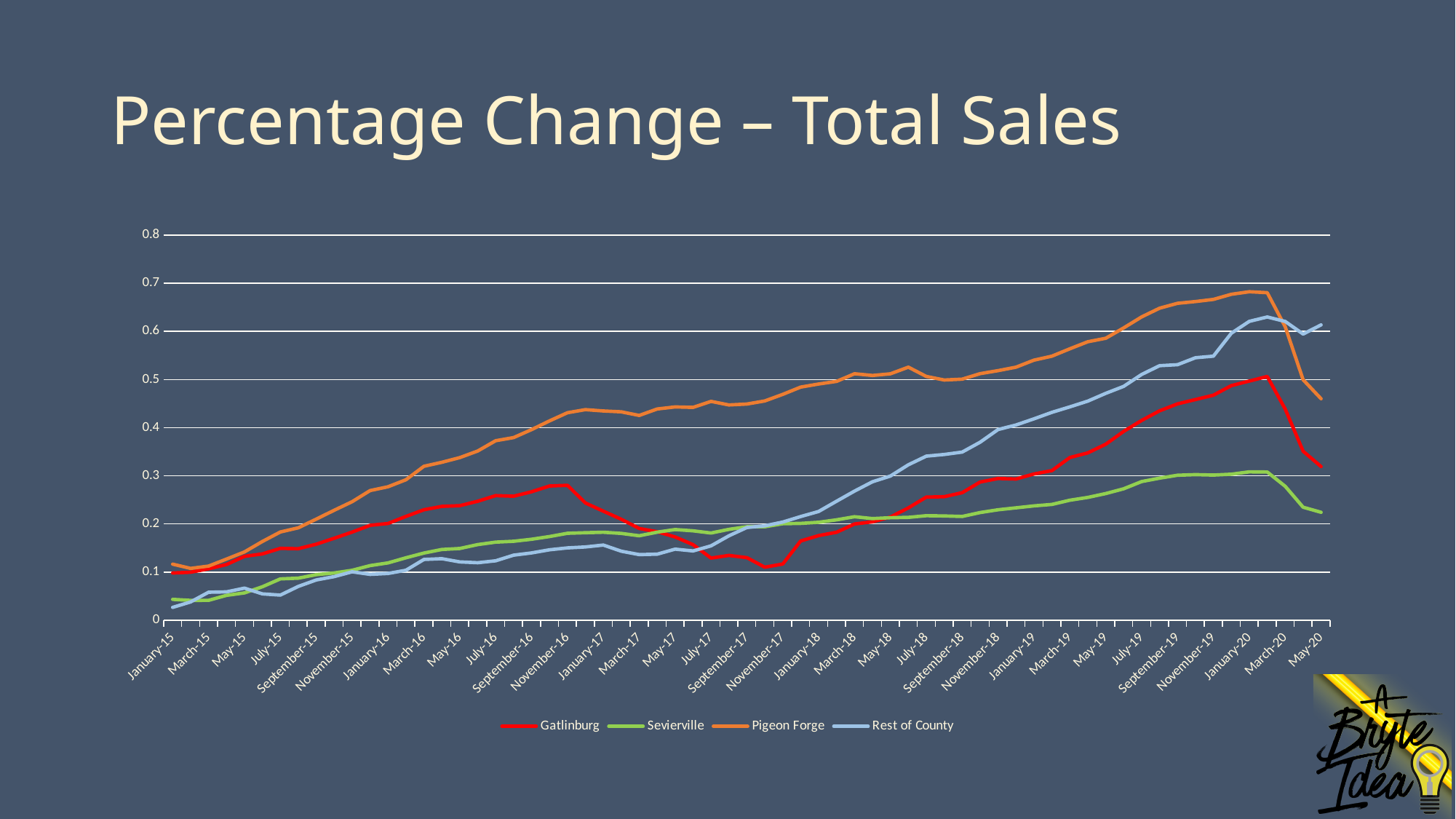
Is the value for Sevierville at May-20 greater or less than 0.3? less What kind of chart is shown on the slide? line chart Which series has the lowest value at May-20? Sevierville Does the Pigeon Forge line generally rise or fall from January-15 to January-20? rise Does the Gatlinburg line rise or fall from March-20 to May-20? fall At January-19, which is larger: Sevierville or Rest of County? Rest of County Which series has the highest value at January-20? Pigeon Forge How many series does the legend list? 4 At May-20, which is larger: Rest of County or Gatlinburg? Rest of County What is the title of the slide? Percentage Change – Total Sales Is the value for Gatlinburg at January-15 greater or less than 0.2? less Is the value for Pigeon Forge at January-20 greater or less than 0.6? greater